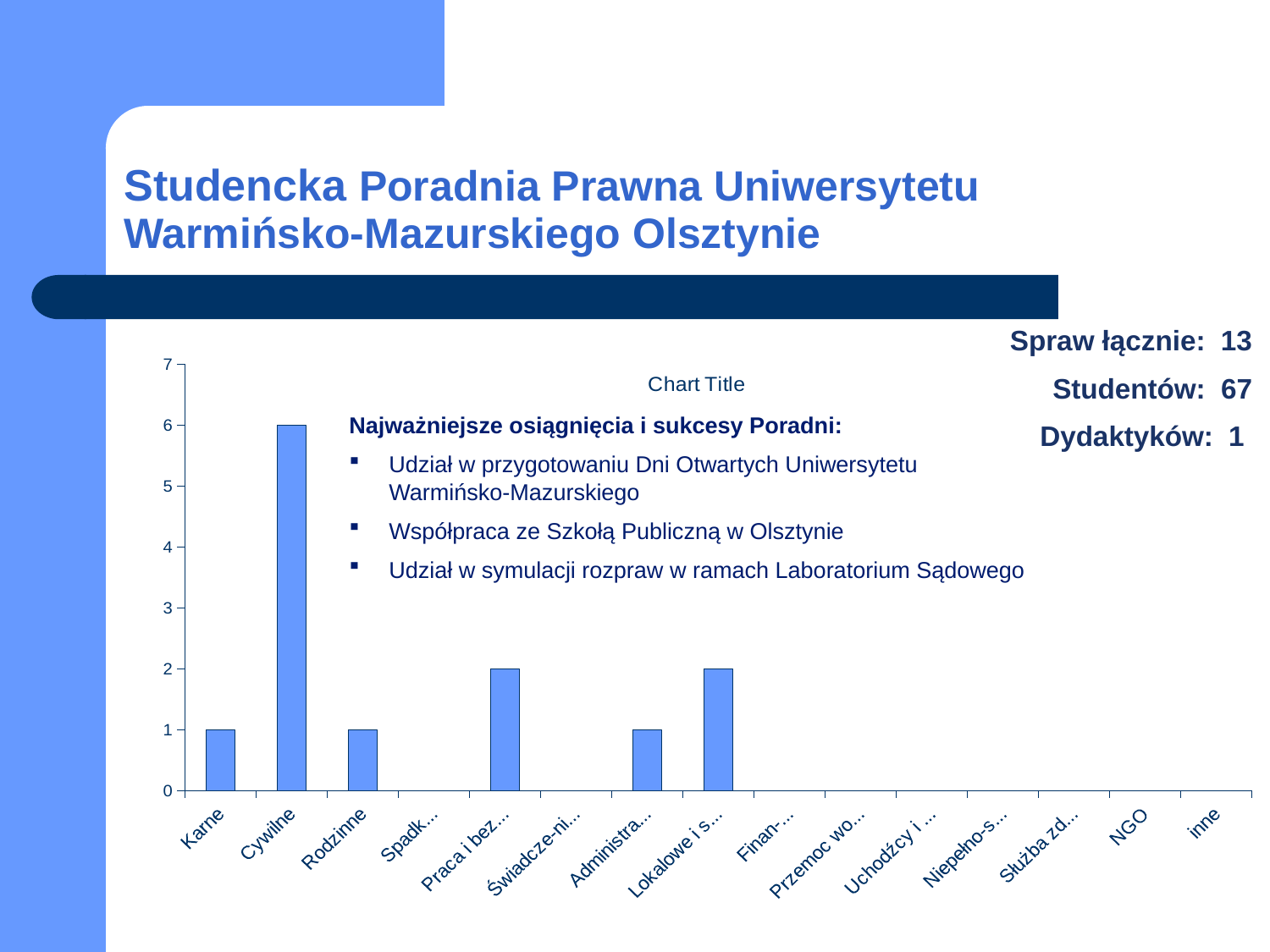
What is the value for inne? 0 Which is larger, the value for Cywilne or the value for Karne? Cywilne What is the value for NGO? 0 What is the title shown on the chart? Chart Title Which category has the highest value? Cywilne How many categories have a value greater than 0? 6 Is the value for Cywilne greater or less than 5? greater What is the value for Karne? 1 What is the value for Cywilne? 6 What kind of chart is shown? bar chart What is the difference between the values for Cywilne and Rodzinne? 5 How many categories are shown on the x axis? 15